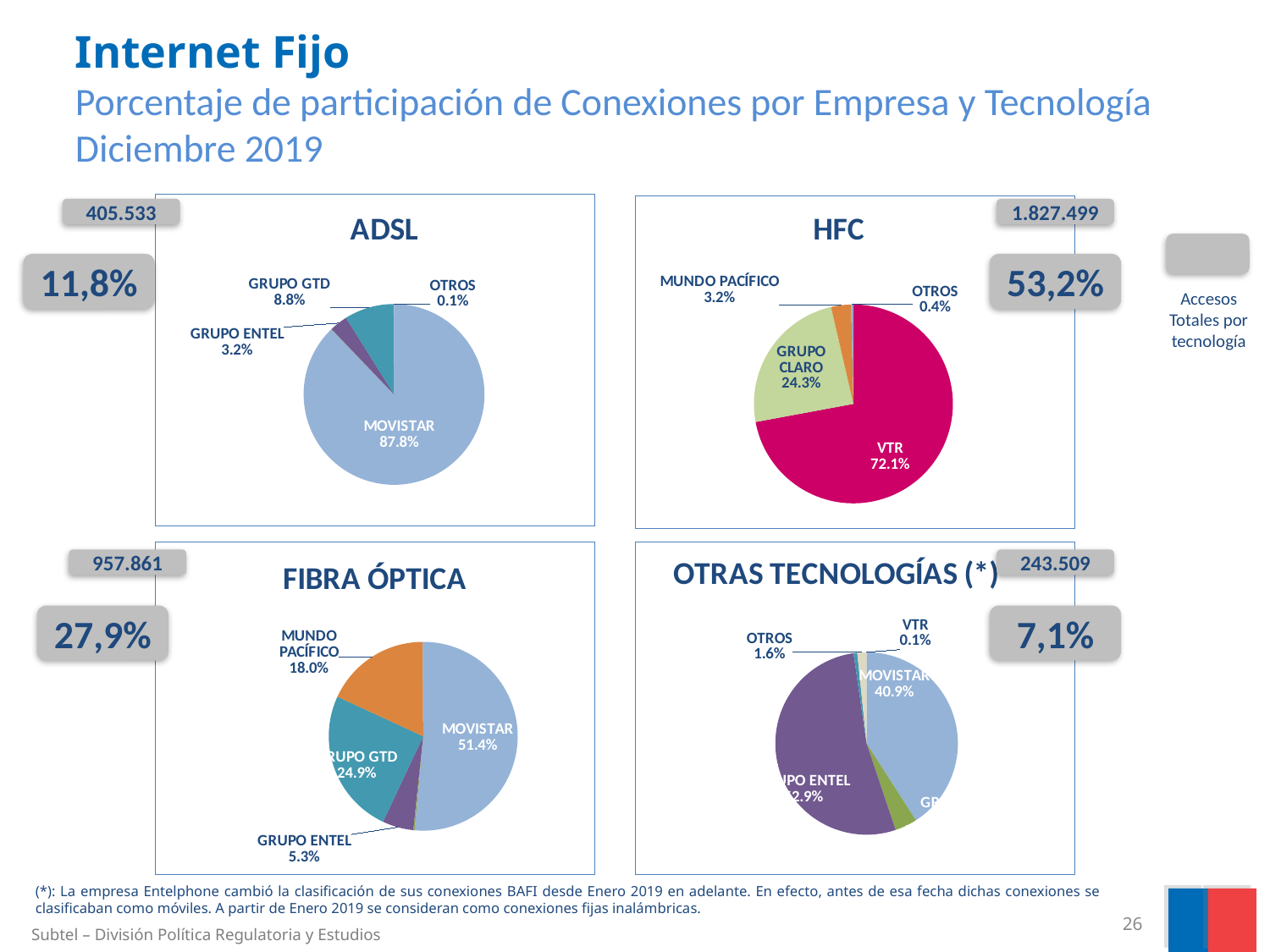
What kind of chart is used for the ADSL data? Pie chart In the FIBRA ÓPTICA chart, what share does MUNDO PACÍFICO hold? 18.0% In the ADSL chart, which company has the smallest share? OTROS In the ADSL chart, what is the share for GRUPO GTD? 8.8% In the FIBRA ÓPTICA chart, what is the share for GRUPO ENTEL? 5.3% In the ADSL chart, what share does MOVISTAR hold? 87.8% In the HFC chart, which company has the largest share? VTR In the HFC chart, what is the difference between the shares of VTR and GRUPO CLARO? 47.8% In the FIBRA ÓPTICA chart, which is larger, the share of MOVISTAR or the share of MUNDO PACÍFICO? MOVISTAR In the HFC chart, what is the share for GRUPO CLARO? 24.3% In the HFC chart, what share does VTR hold? 72.1% In the OTRAS TECNOLOGÍAS (*) chart, what share does MOVISTAR hold? 40.9%